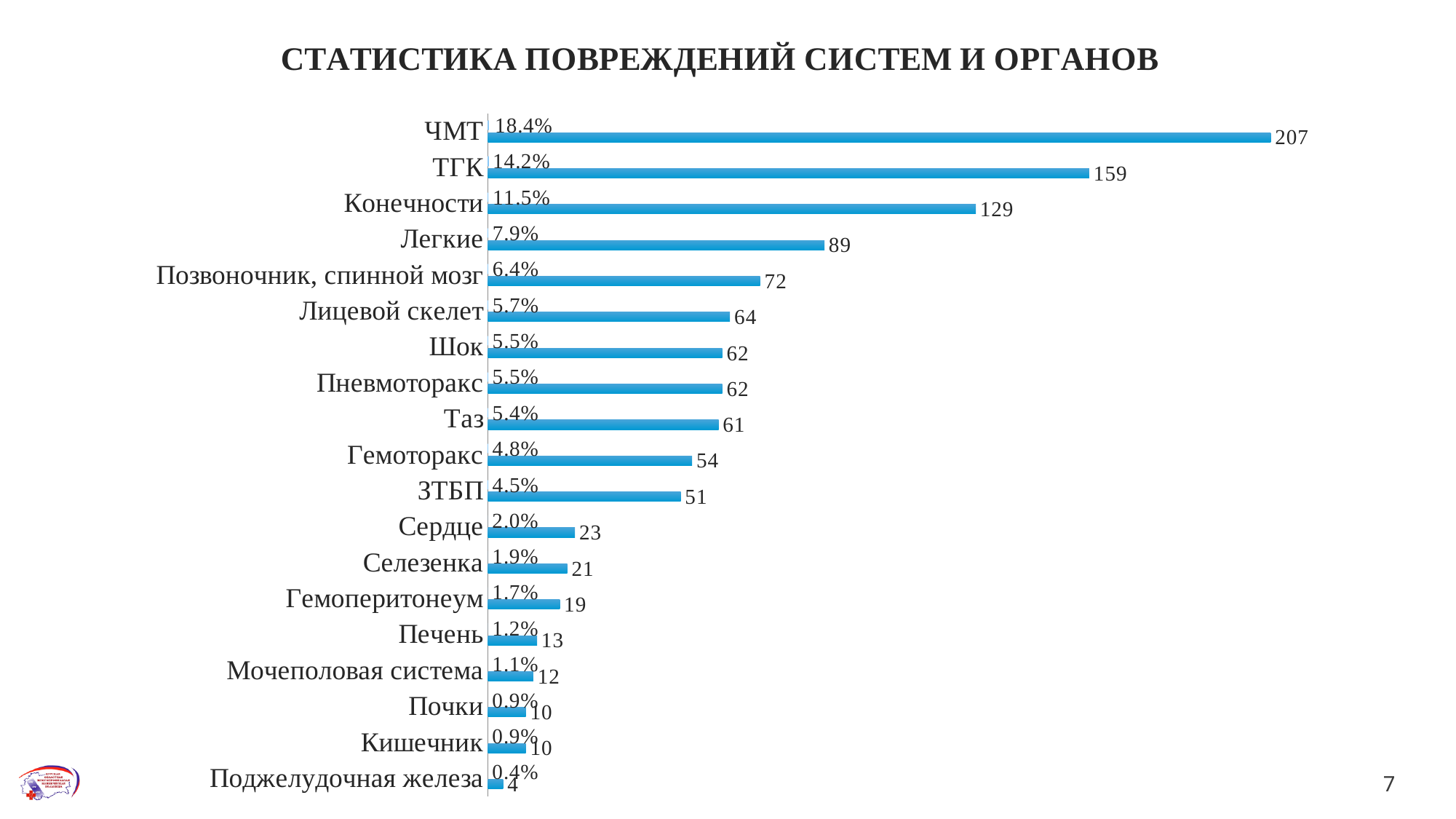
Which category has the highest value? ЧМТ What is the count value shown for ЧМТ? 207 What is the count value shown for Гемоторакс? 54 Which has a larger value, Сердце or Селезенка? Сердце Which category has the lowest value? Поджелудочная железа What is the difference between the count for ЧМТ and the count for ТГК? 48 What is the difference between the count for Легкие and the count for Позвоночник, спинной мозг? 17 What is the title of the slide? СТАТИСТИКА ПОВРЕЖДЕНИЙ СИСТЕМ И ОРГАНОВ What percentage is shown for Конечности? 11.5% How many categories are shown in the chart? 19 What percentage is shown for Поджелудочная железа? 0.4% What type of chart is shown on the slide? Bar chart